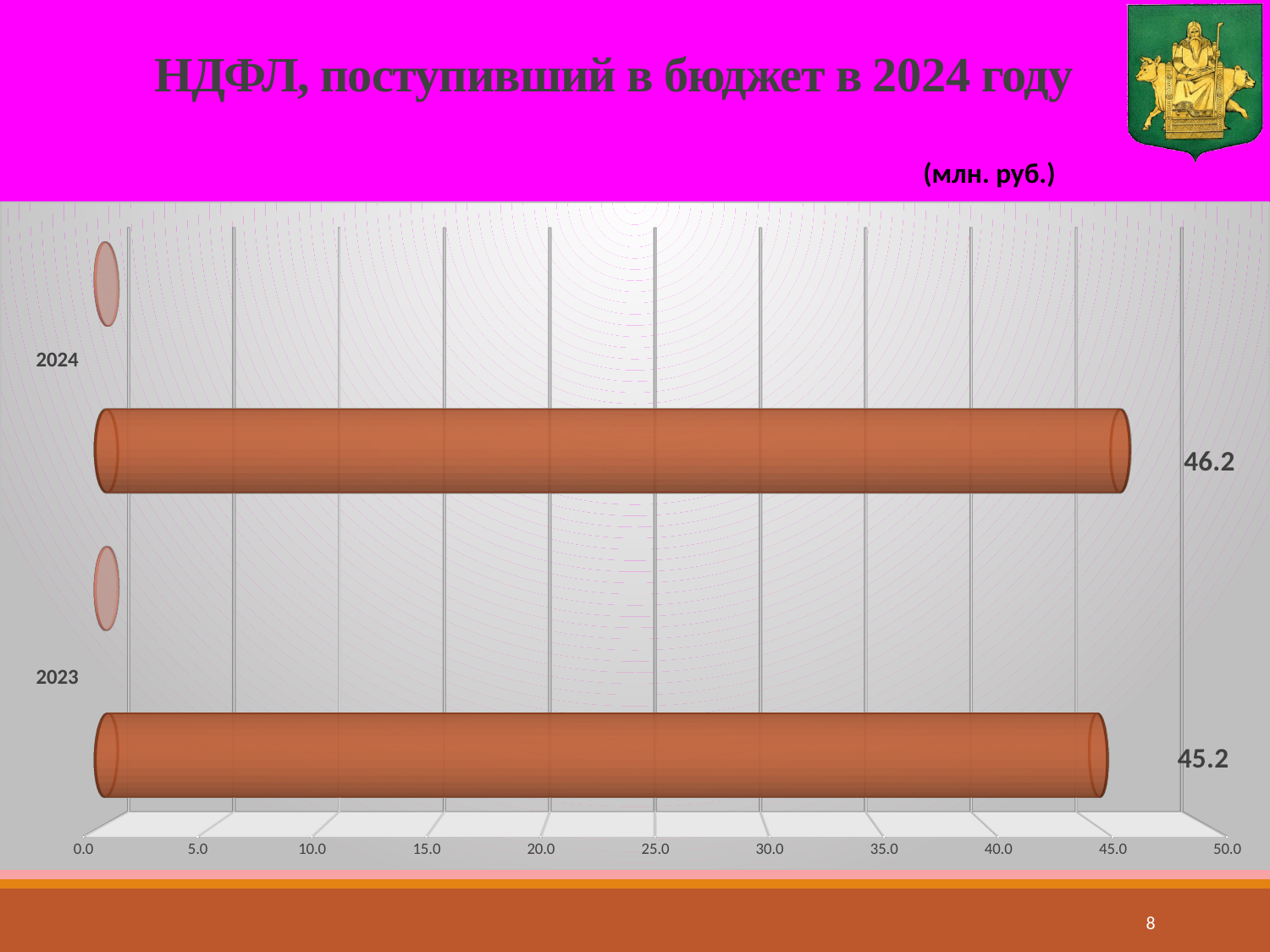
Is the value for 2024 larger than the value for 2023? Yes Did the value rise or fall from 2023 to 2024? Rise Which year has the higher value? 2024 What kind of chart is shown? Bar chart Is the value for 2023 greater or less than 45.0? greater What unit is indicated for the chart values? млн. руб. How many years are shown on the chart? 2 What is the value for 2024? 46.2 Is the value for 2024 greater or less than 50.0? less What is the value for 2023? 45.2 What is the difference between the 2024 and 2023 values? 1.0 Which year has the lower value? 2023